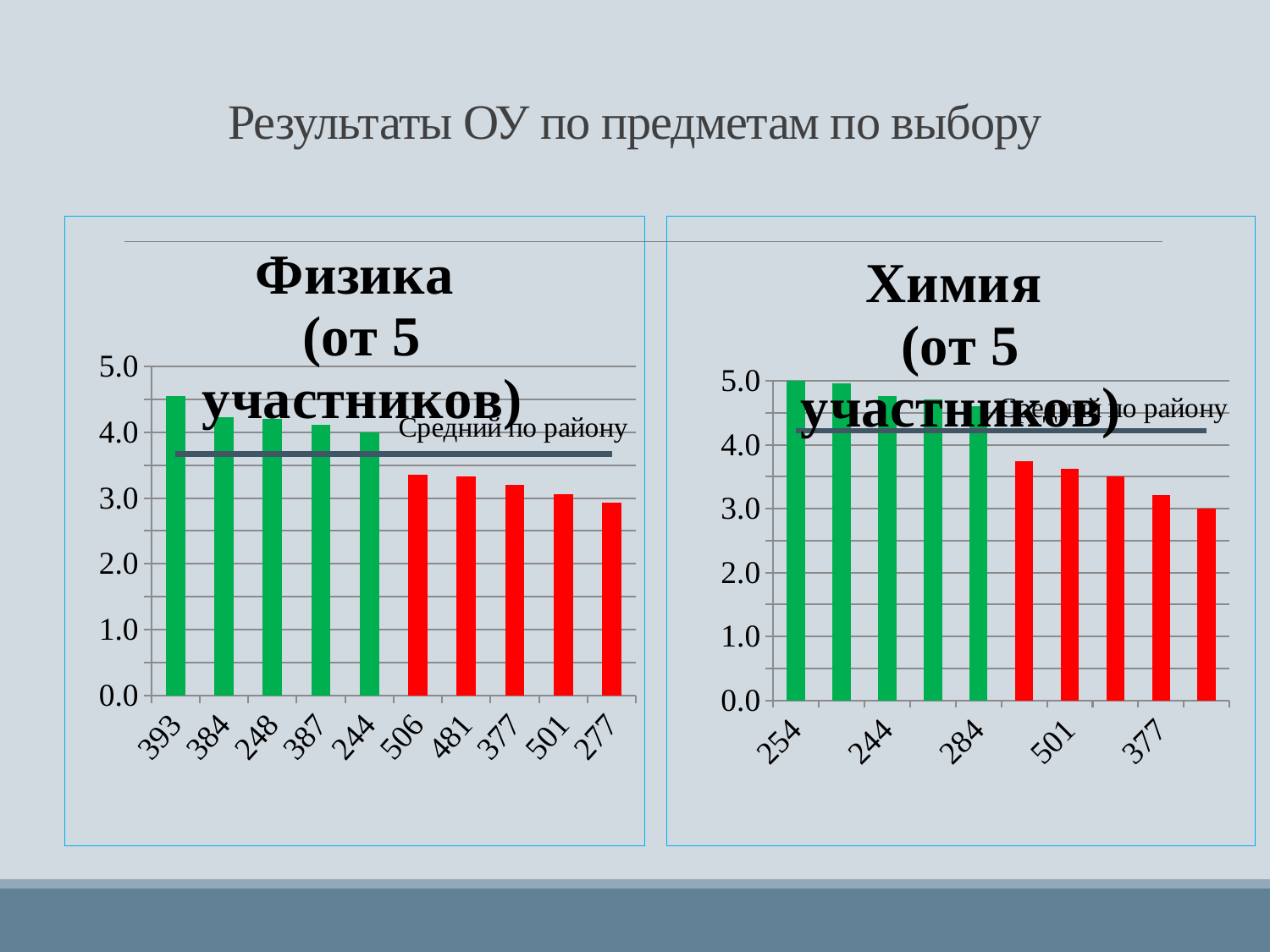
In the Физика chart, which category has the highest value? 393 What is the label of the horizontal line drawn across the Физика chart? Средний по району In the Физика chart, which category has the lowest value? 277 How many bars are plotted in the Физика chart? 10 In the Физика chart, do the bar values rise or fall from left to right? fall In the Химия chart, is the value for 501 greater or less than 4.0? less In the Физика chart, is the value for 393 greater or less than 4.0? greater In the Физика chart, is the value for 277 greater or less than 3.0? less In the Химия chart, which is larger, the value for 254 or the value for 377? 254 In the Физика chart, which is larger, the value for 393 or the value for 506? 393 What kind of chart is the Физика chart? bar chart